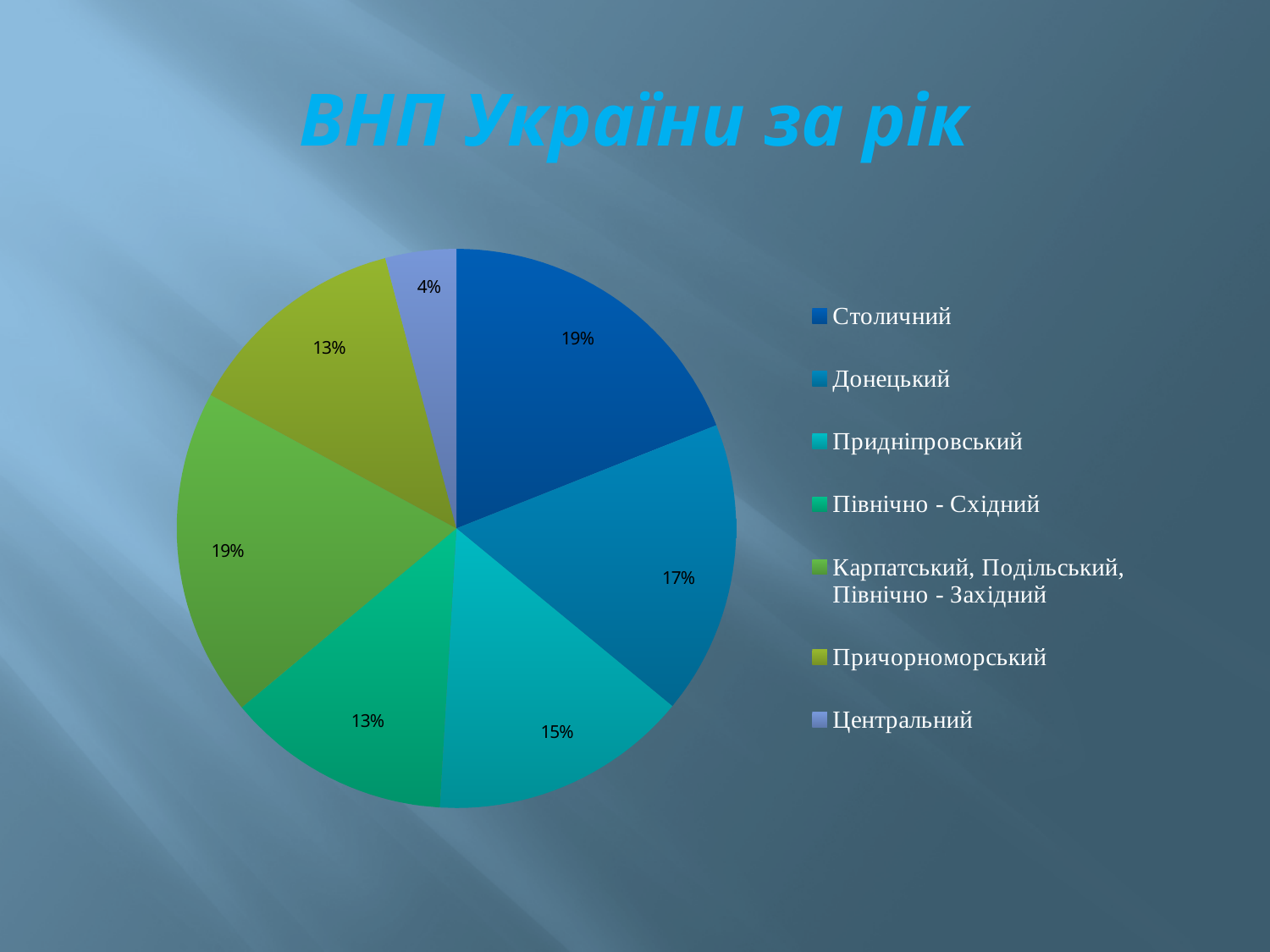
How many slices does the pie chart have? 7 What share of the pie does Придніпровський have? 15% Which region has the smallest share of the pie? Центральний What type of chart is shown on the slide? pie chart What share of the pie does Столичний have? 19% How many entries does the legend list? 7 What share of the pie does Центральний have? 4% What is the title of the chart? ВНП України за рік What is the difference between the shares of Столичний and Центральний? 15% Which has a larger share, Столичний or Причорноморський? Столичний What is the difference between the shares of Донецький and Придніпровський? 2%